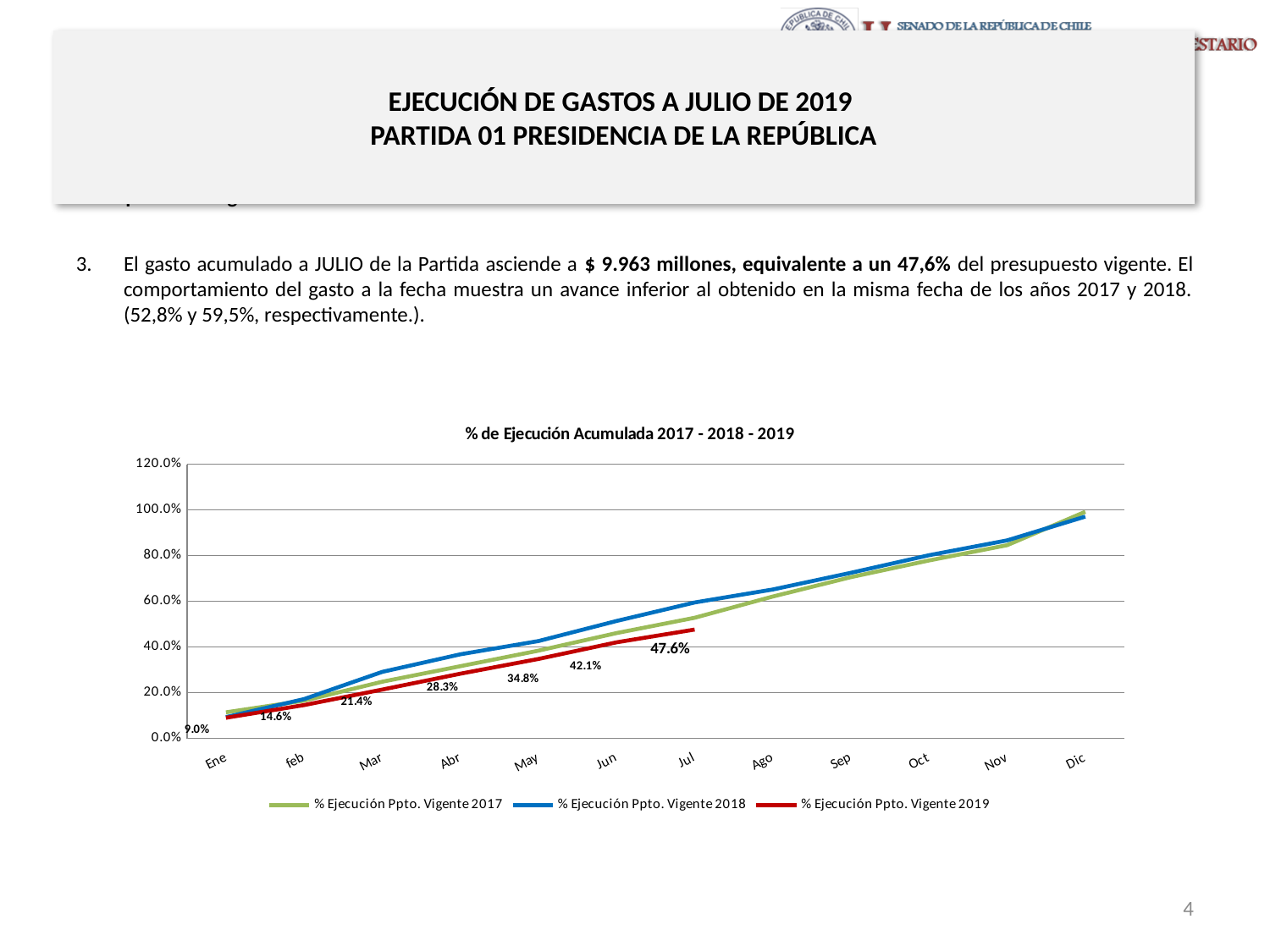
By how many percentage points did % Ejecución Ppto. Vigente 2019 increase from Jun to Jul? 5.5 Does the % Ejecución Ppto. Vigente 2019 line rise or fall from Ene to Jul? rise How many months are shown along the x axis of the chart? 12 What kind of chart is shown on the slide? line chart What is the title of the chart? % de Ejecución Acumulada 2017 - 2018 - 2019 In Jul, which series is higher: % Ejecución Ppto. Vigente 2018 or % Ejecución Ppto. Vigente 2019? % Ejecución Ppto. Vigente 2018 Is the value for % Ejecución Ppto. Vigente 2018 in Dic greater or less than 80.0%? greater What is the value of % Ejecución Ppto. Vigente 2019 in Ene? 9.0% How many series does the legend of the chart list? 3 Is the value for % Ejecución Ppto. Vigente 2017 in Ago greater or less than 80.0%? less What is the value of % Ejecución Ppto. Vigente 2019 in Abr? 28.3% What is the value of % Ejecución Ppto. Vigente 2019 in Jul? 47.6%